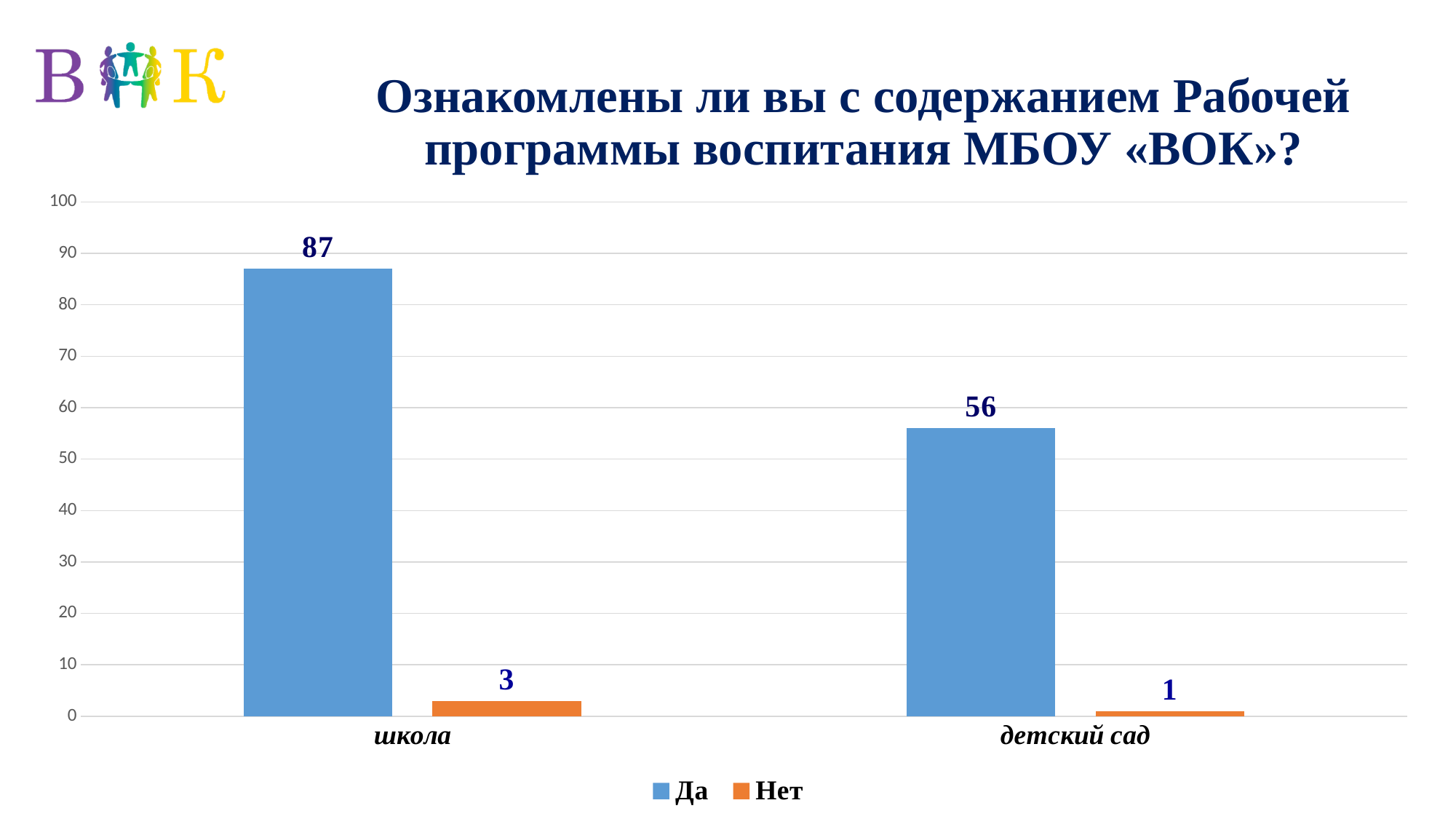
Which colour represents the "Нет" series? orange What is the value for "Да" in the "школа" category? 87 How many categories are shown on the x axis? 2 Which category has the lowest "Нет" value? детский сад What is the value for "Нет" in the "школа" category? 3 What kind of chart is shown on the slide? bar chart What is the difference between the "Да" values for "школа" and "детский сад"? 31 What is the value for "Да" in the "детский сад" category? 56 Which is larger: the "Да" value for "школа" or the "Да" value for "детский сад"? школа How many series does the legend list? 2 Which category has the highest "Да" value? школа What is the value for "Нет" in the "детский сад" category? 1